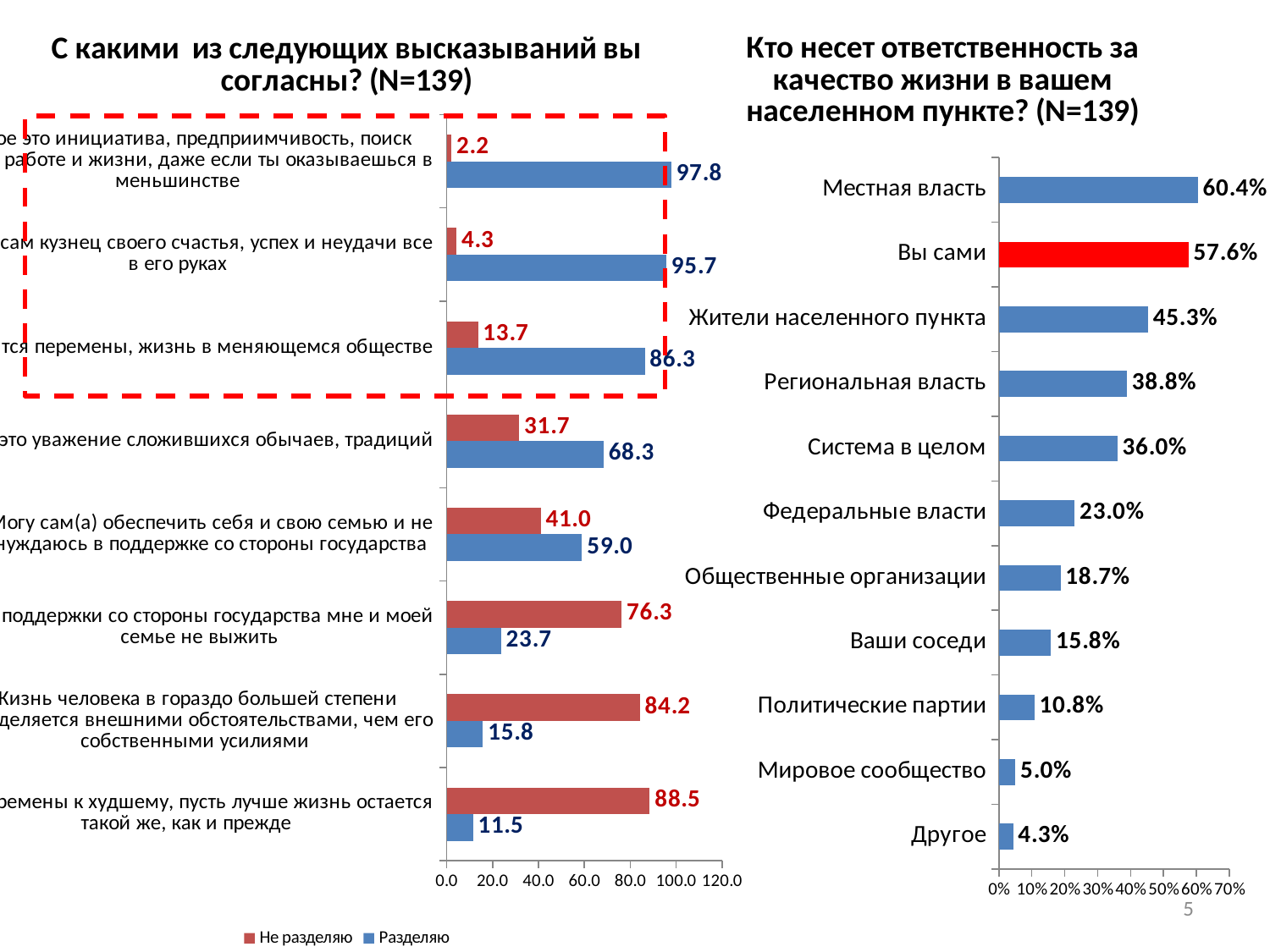
On the chart 'С какими из следующих высказываний вы согласны?', what is the 'Разделяю' value for the statement beginning 'Жизнь человека в гораздо большей степени'? 15.8 On the chart 'Кто несет ответственность за качество жизни в вашем населенном пункте?', which category has the lowest value? Другое On the chart 'Кто несет ответственность за качество жизни в вашем населенном пункте?', how many categories are shown? 11 On the chart 'Кто несет ответственность за качество жизни в вашем населенном пункте?', which bar is coloured red? Вы сами On the chart 'Кто несет ответственность за качество жизни в вашем населенном пункте?', which is larger: 'Федеральные власти' or 'Общественные организации'? Федеральные власти On the chart 'Кто несет ответственность за качество жизни в вашем населенном пункте?', which category has the highest value? Местная власть On the chart 'Кто несет ответственность за качество жизни в вашем населенном пункте?', what is the value for 'Местная власть'? 60.4% What kind of chart is 'С какими из следующих высказываний вы согласны?'? Bar chart On the chart 'Кто несет ответственность за качество жизни в вашем населенном пункте?', what is the difference between 'Жители населенного пункта' and 'Ваши соседи'? 29.5% On the chart 'Кто несет ответственность за качество жизни в вашем населенном пункте?', what is the value for 'Региональная власть'? 38.8% On the chart 'С какими из следующих высказываний вы согласны?', how many series does the legend list? 2 On the chart 'С какими из следующих высказываний вы согласны?', what is the 'Не разделяю' value for the statement ending 'семье не выжить'? 76.3